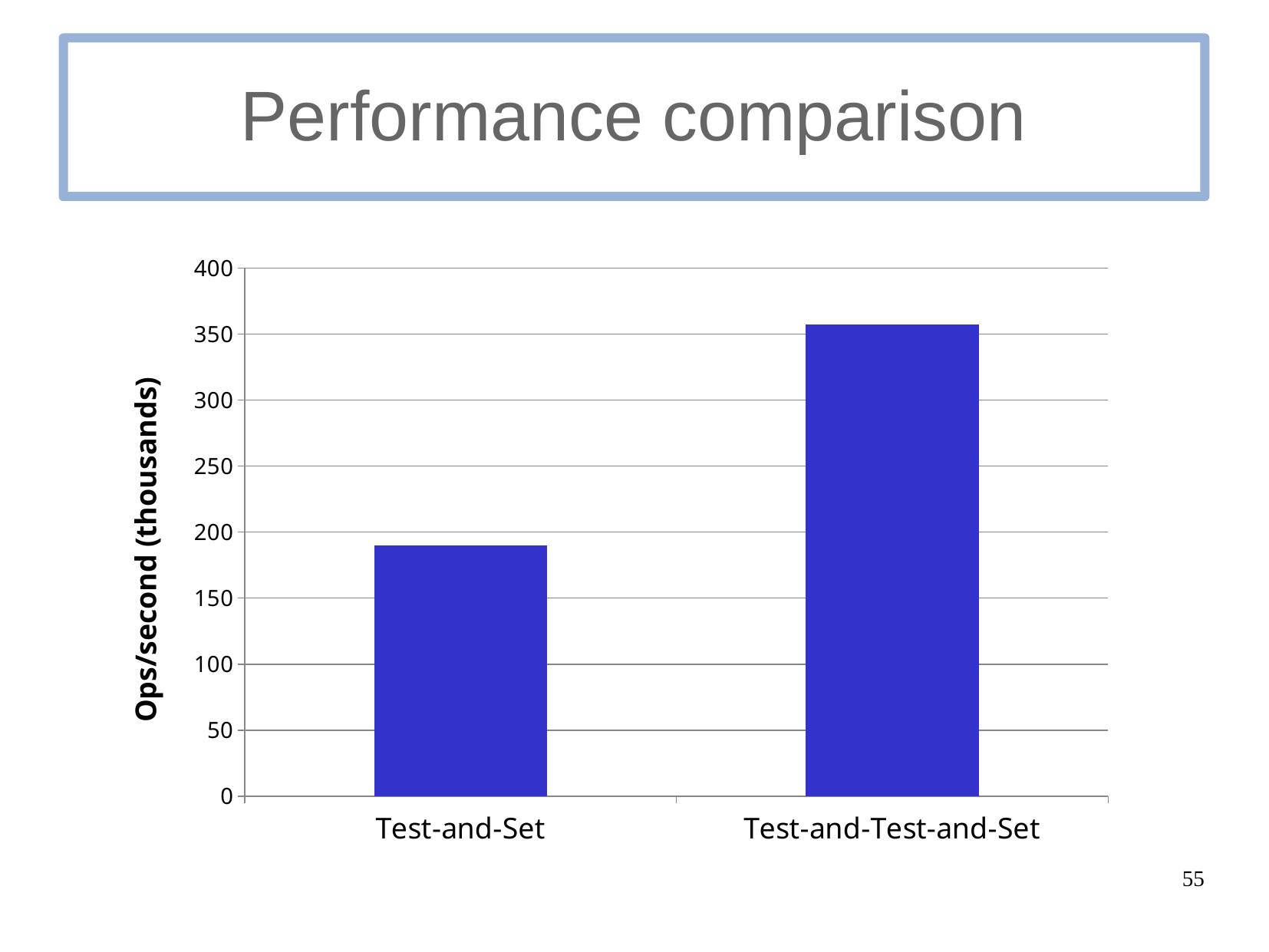
Which is larger, the value for Test-and-Set or the value for Test-and-Test-and-Set? Test-and-Test-and-Set Is the value for Test-and-Set greater or less than 150? greater Which category has the highest value? Test-and-Test-and-Set Is the value for Test-and-Test-and-Set greater or less than 400? less Which category has the lowest value? Test-and-Set Is the value for Test-and-Test-and-Set greater or less than 300? greater How many bars does the chart show? 2 What is the title of the slide containing the chart? Performance comparison What is the label on the vertical axis of the chart? Ops/second (thousands) What kind of chart is shown on the slide? bar chart